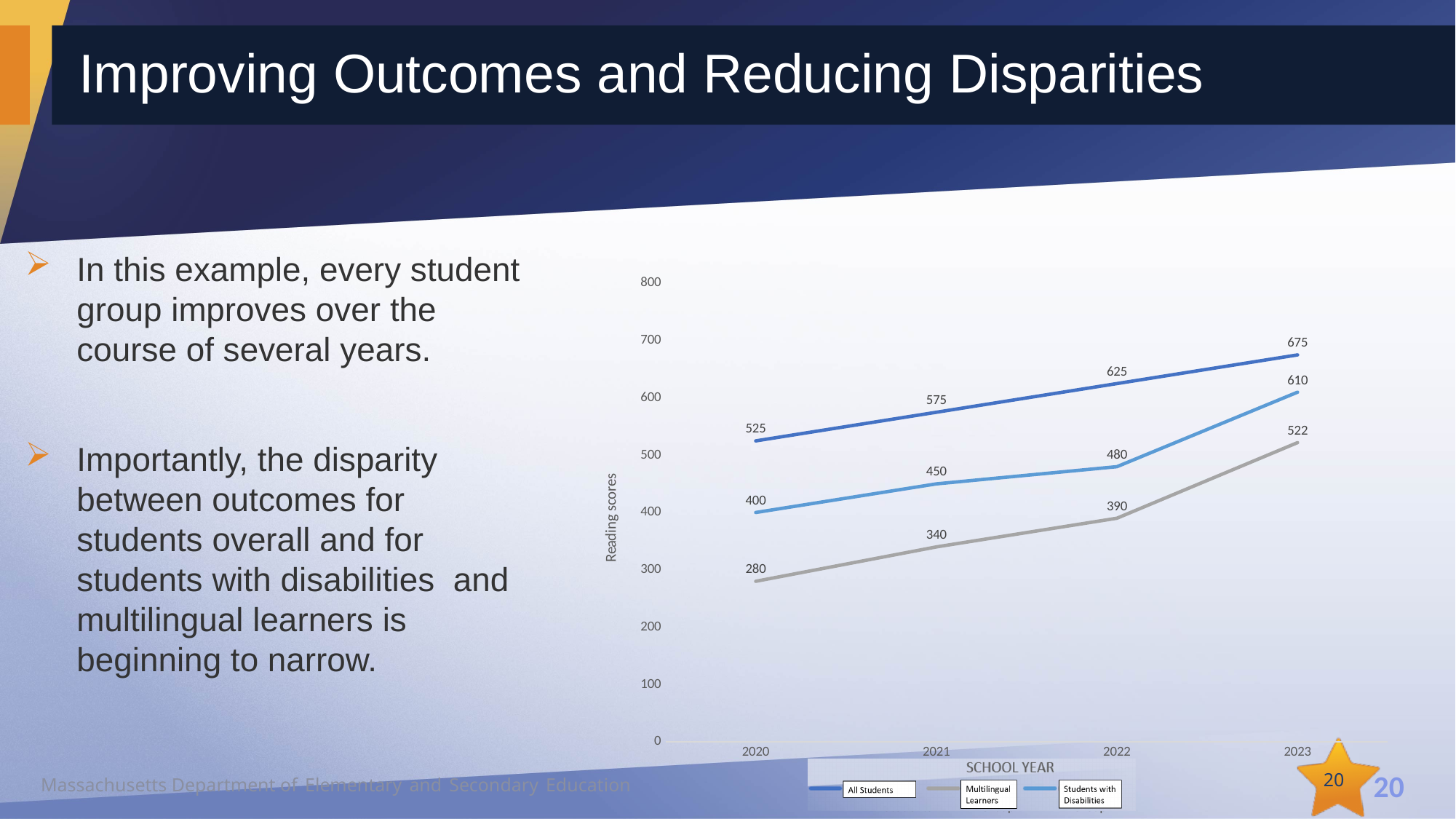
In 2021, which is larger: the score for Students with Disabilities or the score for Multilingual Learners? Students with Disabilities How many series does the legend list? 3 What is the reading score for Multilingual Learners in 2020? 280 How many school years are shown on the x axis? 4 By how much did the Students with Disabilities score increase from 2022 to 2023? 130 Which school year has the highest reading score for Multilingual Learners? 2023 Do the reading scores for All Students rise or fall from 2020 to 2023? rise What is the reading score for Students with Disabilities in 2022? 480 Which school year has the lowest reading score for Students with Disabilities? 2020 What kind of chart is shown on the slide? line chart What is the reading score for All Students in 2023? 675 What is the difference between the All Students score and the Multilingual Learners score in 2023? 153